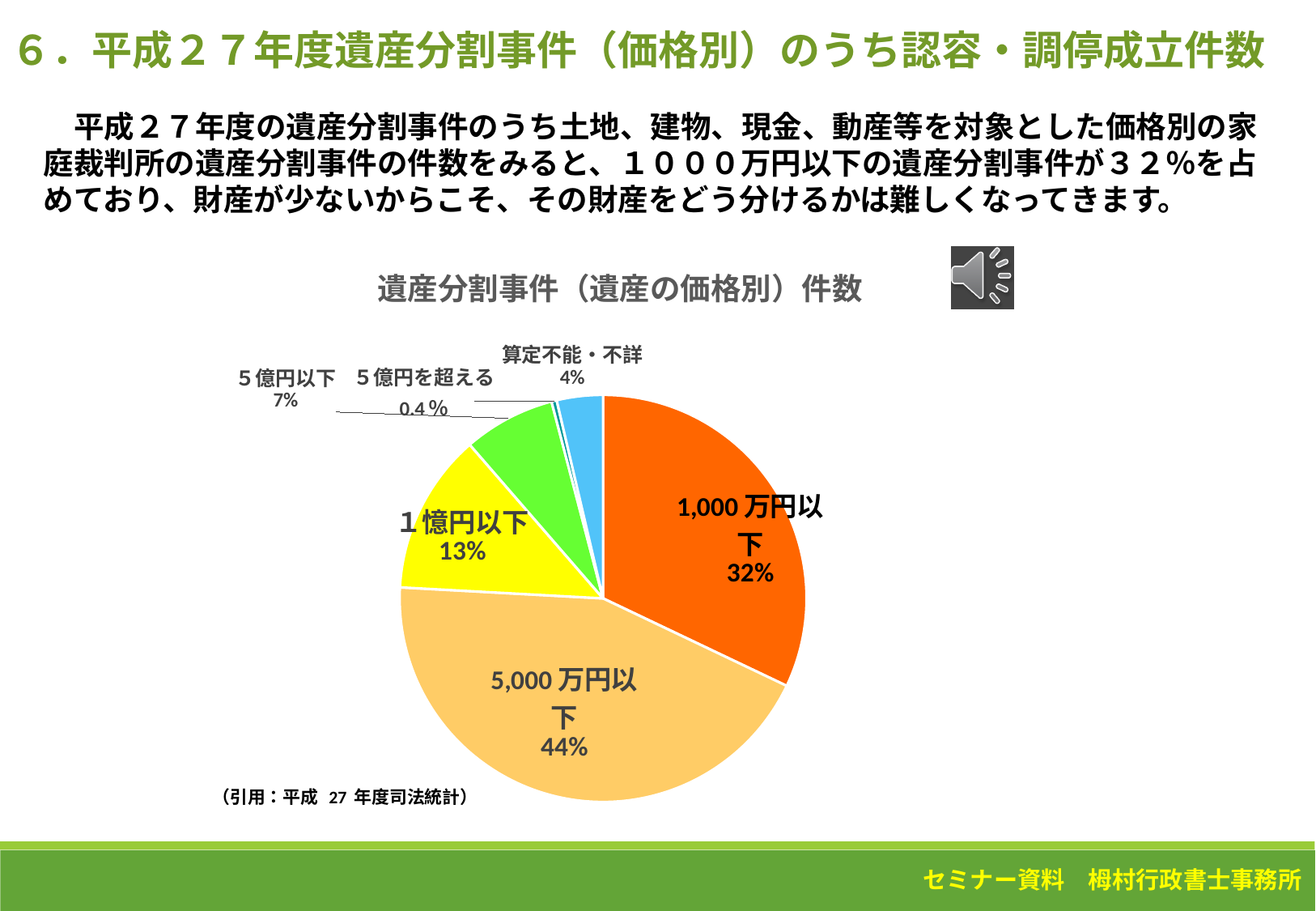
Which category has the largest slice of the pie? 5,000万円以下 How many slices does the pie chart have? 6 What is the difference in percentage points between the 5,000万円以下 slice and the 1,000万円以下 slice? 12 What percentage is shown for the 5億円を超える slice? 0.4％ What percentage is shown for the 1,000万円以下 slice? 32% What type of chart is shown on the slide? Pie chart Which category has the smallest slice of the pie? 5億円を超える What share of the pie does the 5,000万円以下 slice represent? 44% What percentage is shown for the 1億円以下 slice? 13% What percentage is shown for the 5億円以下 slice? 7% What percentage is shown for the 算定不能・不詳 slice? 4% Which is larger, the 1億円以下 slice or the 5億円以下 slice? 1億円以下